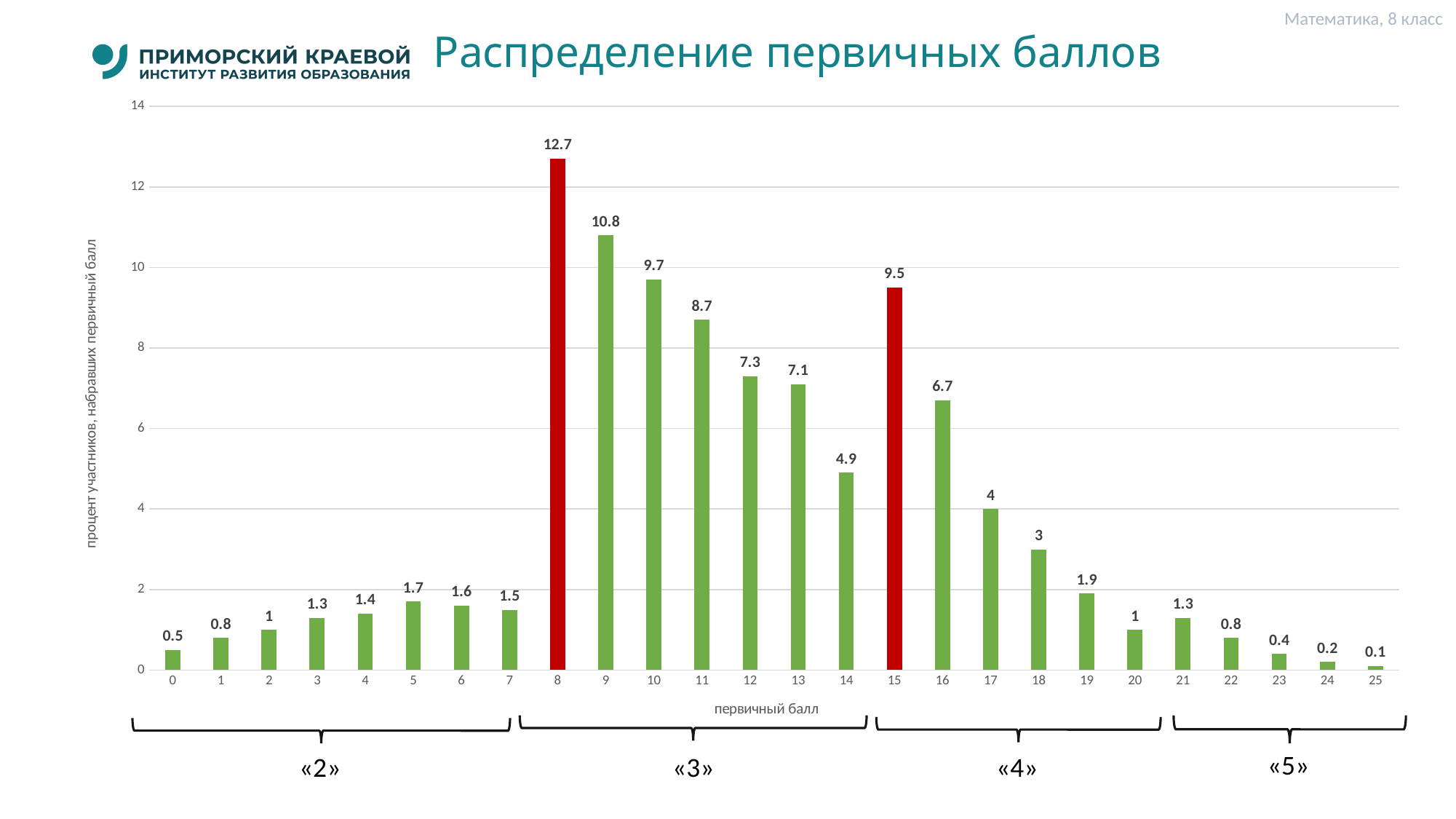
Which primary score has the highest percentage of participants? 8 How many primary score categories are shown on the x axis? 26 Which has a larger value: primary score 16 or primary score 14? 16 What is the difference between the values for primary scores 8 and 9? 1.9 What is the value shown for primary score 0? 0.5 What is the value shown for primary score 15? 9.5 Which two bars are coloured red instead of green? 8 and 15 What percentage of participants scored a primary score of 8? 12.7 Which primary score has the lowest percentage of participants? 25 Do the values rise or fall from primary score 9 to primary score 14? fall What type of chart is shown on the slide? bar chart What is the title of the chart? Распределение первичных баллов